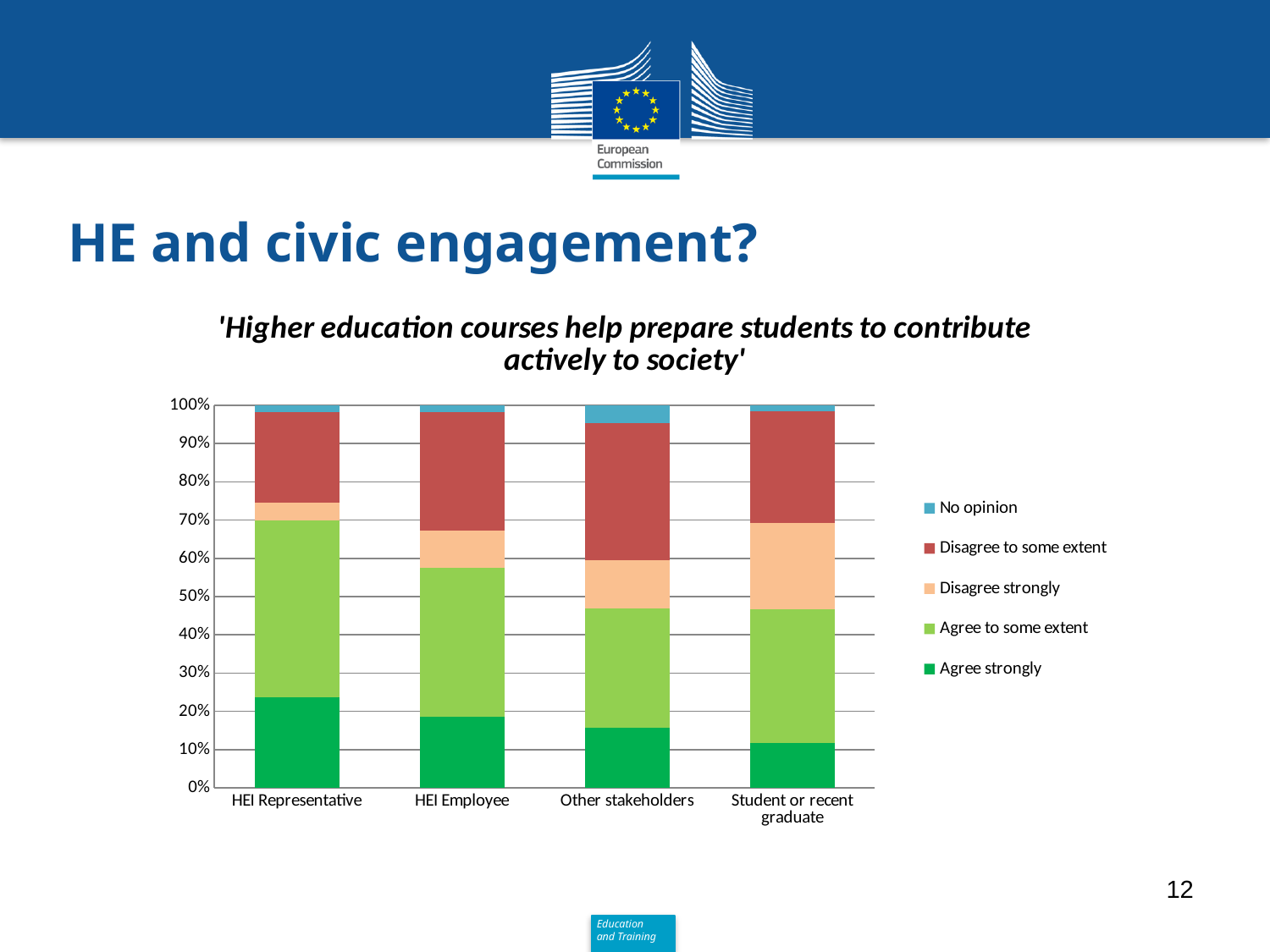
How many respondent categories are shown along the x axis of the chart? 4 Which has the larger 'Agree strongly' share, HEI Employee or Other stakeholders? HEI Employee What kind of chart is shown on the slide? Stacked bar chart Is the 'Agree strongly' value for Student or recent graduate greater or less than 20%? less Which respondent category has the largest 'Agree strongly' share? HEI Representative Which respondent category has the smallest 'Agree strongly' share? Student or recent graduate Is the 'Agree strongly' value for HEI Representative greater or less than 20%? greater Is the 'Agree strongly' value for Other stakeholders greater or less than 10%? greater How many series does the chart's legend list? 5 Which respondent category has the largest 'No opinion' share? Other stakeholders Does the 'Agree strongly' share rise or fall moving from left to right across the categories? Fall What statement is given as the title of the chart? 'Higher education courses help prepare students to contribute actively to society'